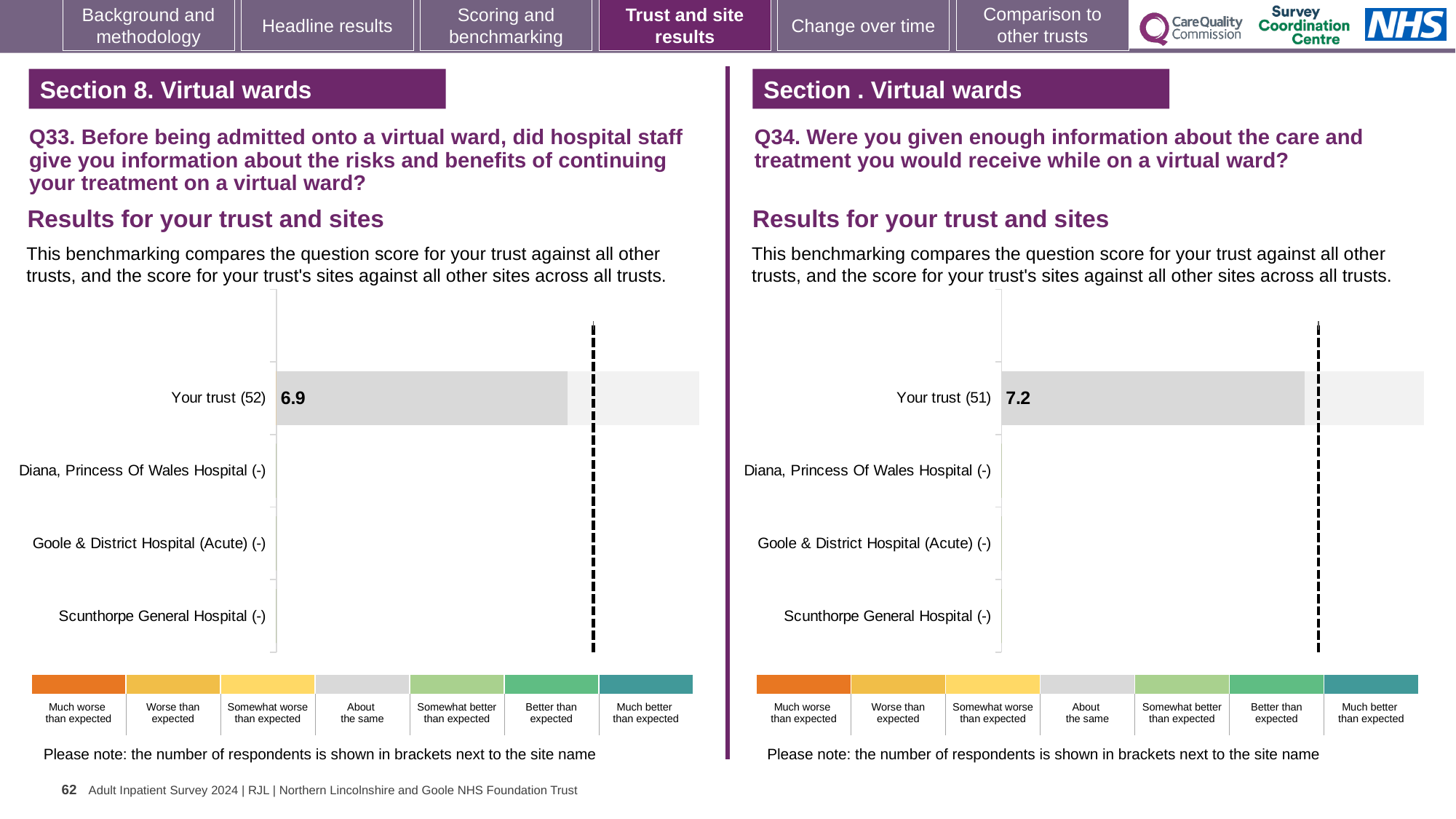
How many categories are listed on the y axis of the left chart (Q33)? 4 In the left chart (Q33), what is the score for Your trust? 6.9 How many bands are shown in the colour key below the left chart (Q33)? 7 In the left chart (Q33), which category has the highest score? Your trust (52) In the right chart (Q34), how many respondents are shown in brackets for Your trust? 51 In the left chart (Q33), how many respondents are shown in brackets for Your trust? 52 How many categories are listed on the y axis of the right chart (Q34)? 4 What is the difference between the Your trust score in the right chart (Q34) and the Your trust score in the left chart (Q33)? 0.3 Which chart shows a higher score for Your trust, the left chart (Q33) or the right chart (Q34)? The right chart (Q34) What kind of chart is the left chart (Q33)? Bar chart In the right chart (Q34), which category has the highest score? Your trust (51) In the right chart (Q34), what is the score for Your trust? 7.2